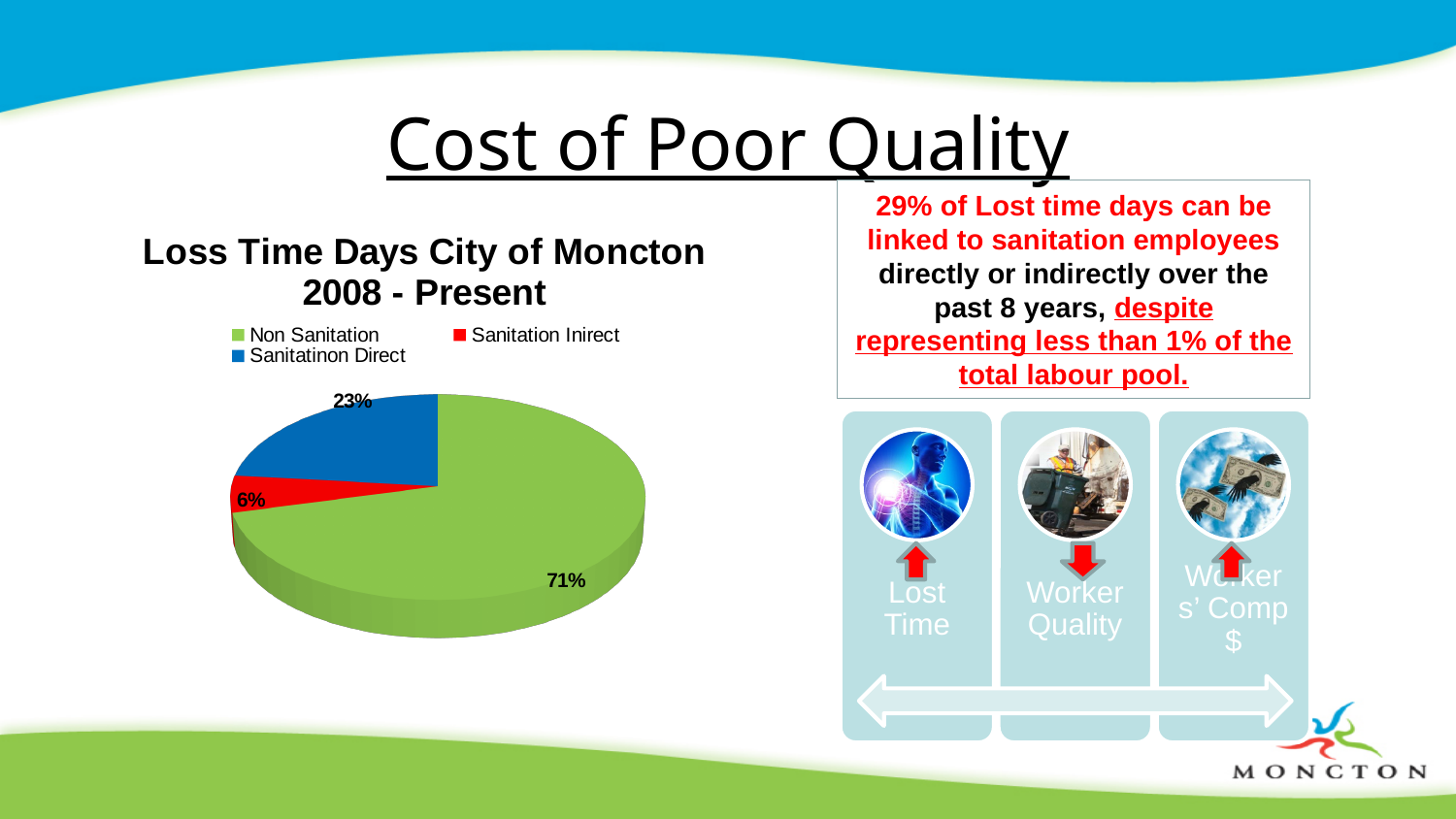
What percentage of loss time days is attributed to Sanitation Inirect? 6% What is the difference in percentage points between the Non Sanitation slice and the Sanitatinon Direct slice? 48 percentage points How many slices does the pie chart have? 3 Which category has the largest share of the pie? Non Sanitation How many entries does the chart legend list? 3 What is the combined share of the Sanitatinon Direct and Sanitation Inirect slices? 29% What percentage of loss time days is attributed to Non Sanitation? 71% What percentage of loss time days is attributed to Sanitatinon Direct? 23% What kind of chart is shown on the slide? pie chart Which category has the smallest share of the pie? Sanitation Inirect What is the title of the chart? Loss Time Days City of Moncton 2008 - Present Which is larger, the Sanitatinon Direct slice or the Sanitation Inirect slice? Sanitatinon Direct